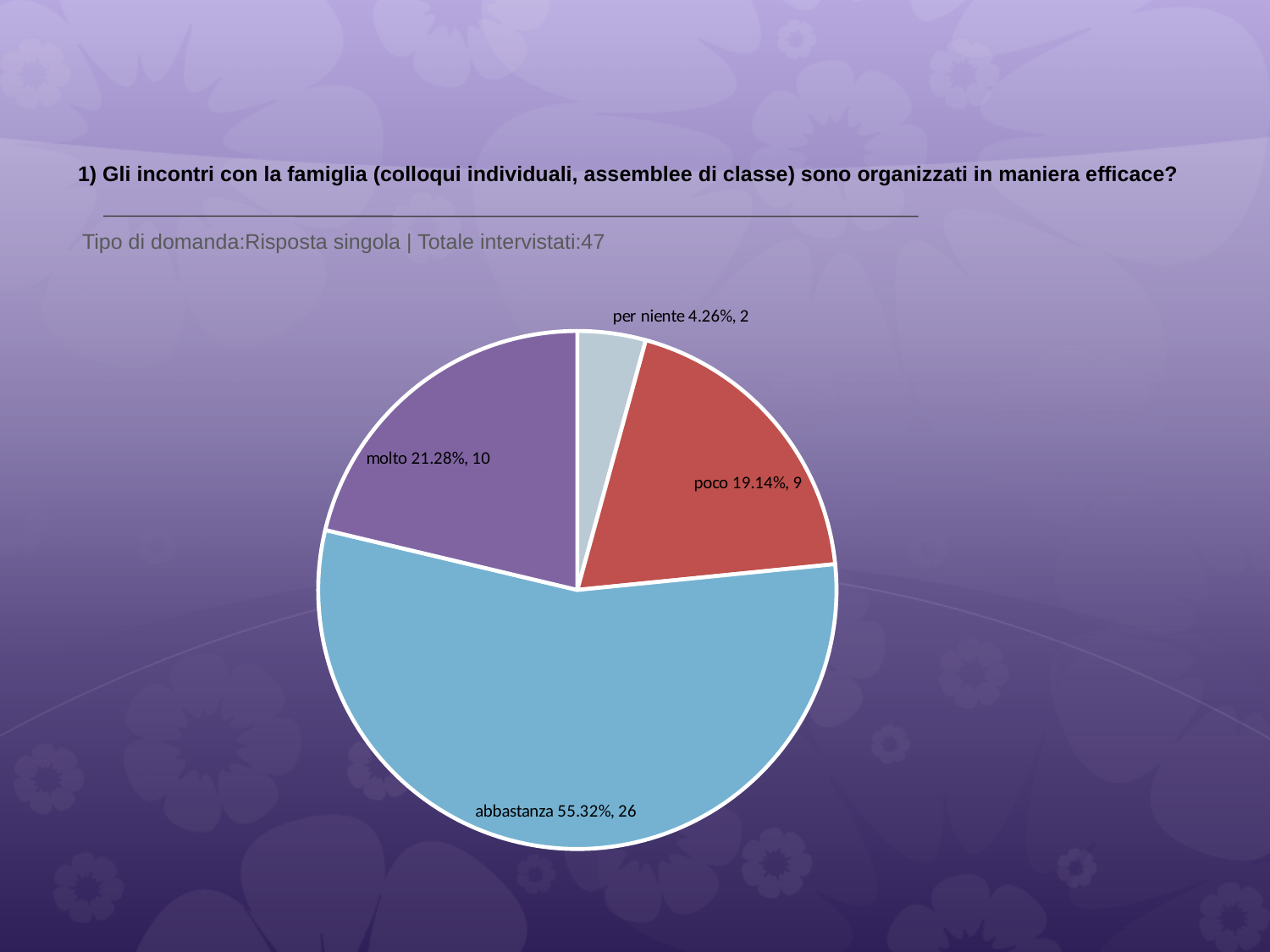
What colour is the 'poco' slice? red Which category has the largest slice? abbastanza What is the total number of respondents stated on the slide? 47 What percentage share does the 'abbastanza' slice have? 55.32% What kind of chart is shown on the slide? pie chart What percentage share does the 'per niente' slice have? 4.26% Which category has the smallest slice? per niente How many slices does the pie chart have? 4 Which is larger, the count for 'molto' or the count for 'poco'? molto How many respondents answered 'poco'? 9 What is the difference between the number of 'abbastanza' responses and the number of 'molto' responses? 16 How many respondents answered 'molto'? 10